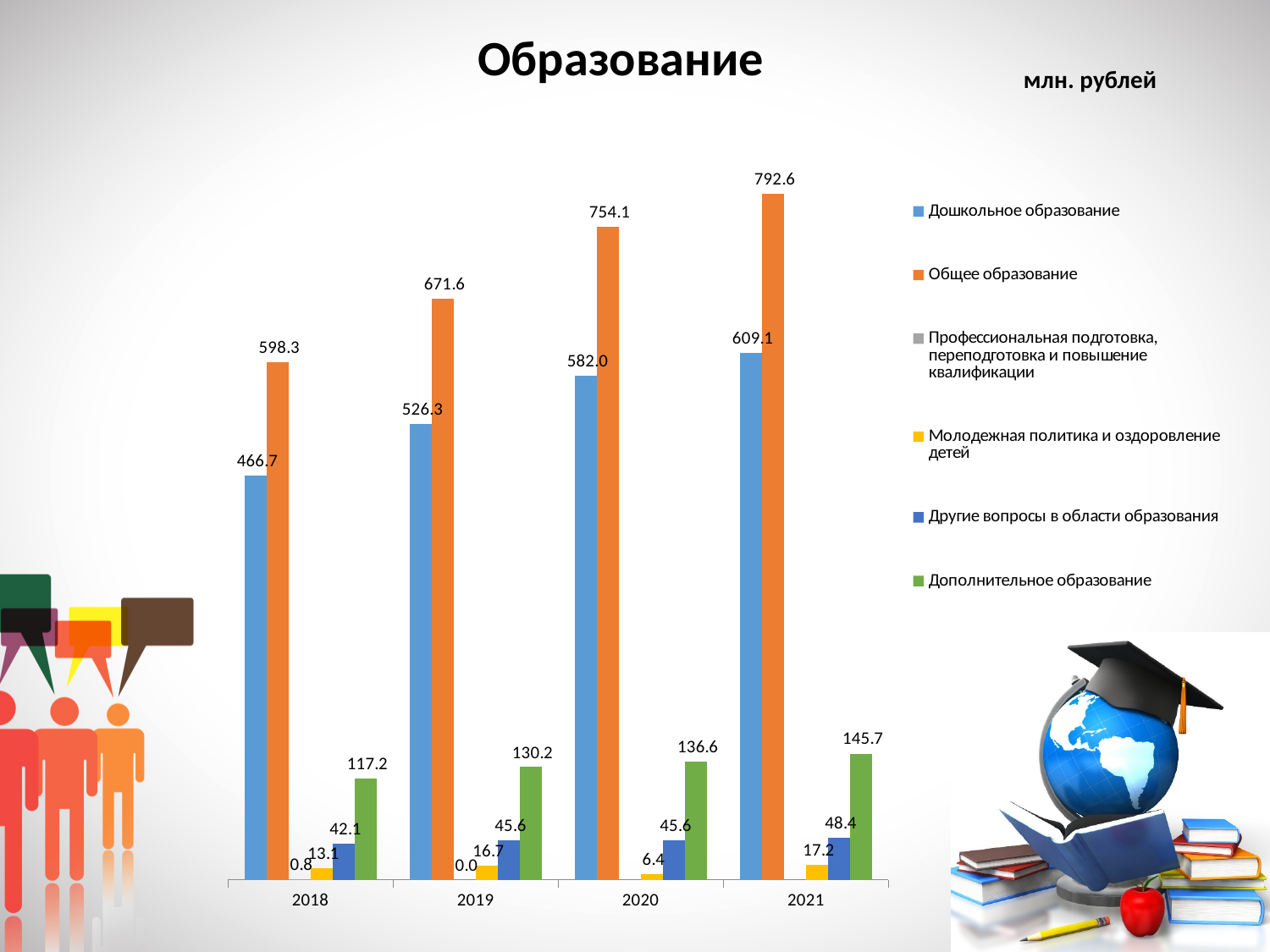
How many years are shown on the x axis? 4 What is the difference between Общее образование and Дошкольное образование in 2020? 172.1 What is the value for Молодежная политика и оздоровление детей in 2019? 16.7 How many series does the legend list? 6 What is the value for Дошкольное образование in 2018? 466.7 In which year is the value for Общее образование the highest? 2021 What is the value for Общее образование in 2021? 792.6 What kind of chart is shown on the slide? bar chart Which is larger in 2019: Дополнительное образование or Другие вопросы в области образования? Дополнительное образование In which year is the value for Дошкольное образование the lowest? 2018 Does the value for Дополнительное образование rise or fall from 2018 to 2021? rise What is the value for Дополнительное образование in 2020? 136.6